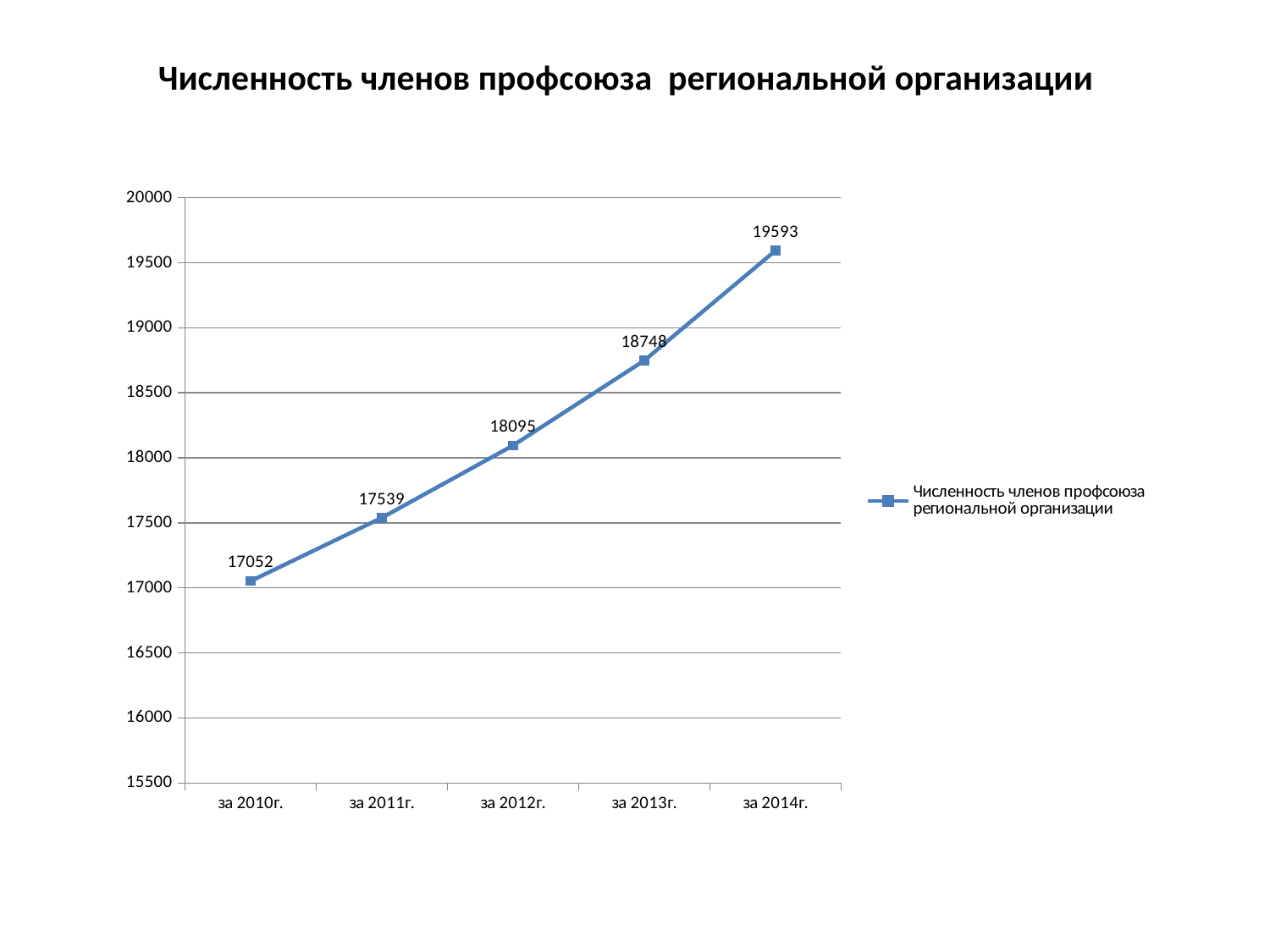
What is the value for за 2012г.? 18095 How many data points are plotted on the chart? 5 What is the value for за 2010г.? 17052 What is the difference between the values for за 2014г. and за 2010г.? 2541 Is the value for за 2011г. greater or less than 18000? less What is the value for за 2014г.? 19593 What kind of chart is shown on the slide? line chart Do the values rise or fall from за 2010г. to за 2014г.? rise What is the difference between the values for за 2013г. and за 2012г.? 653 Which year has the lowest value? за 2010г. Which is larger, the value for за 2011г. or за 2013г.? за 2013г. Which year has the highest value? за 2014г.